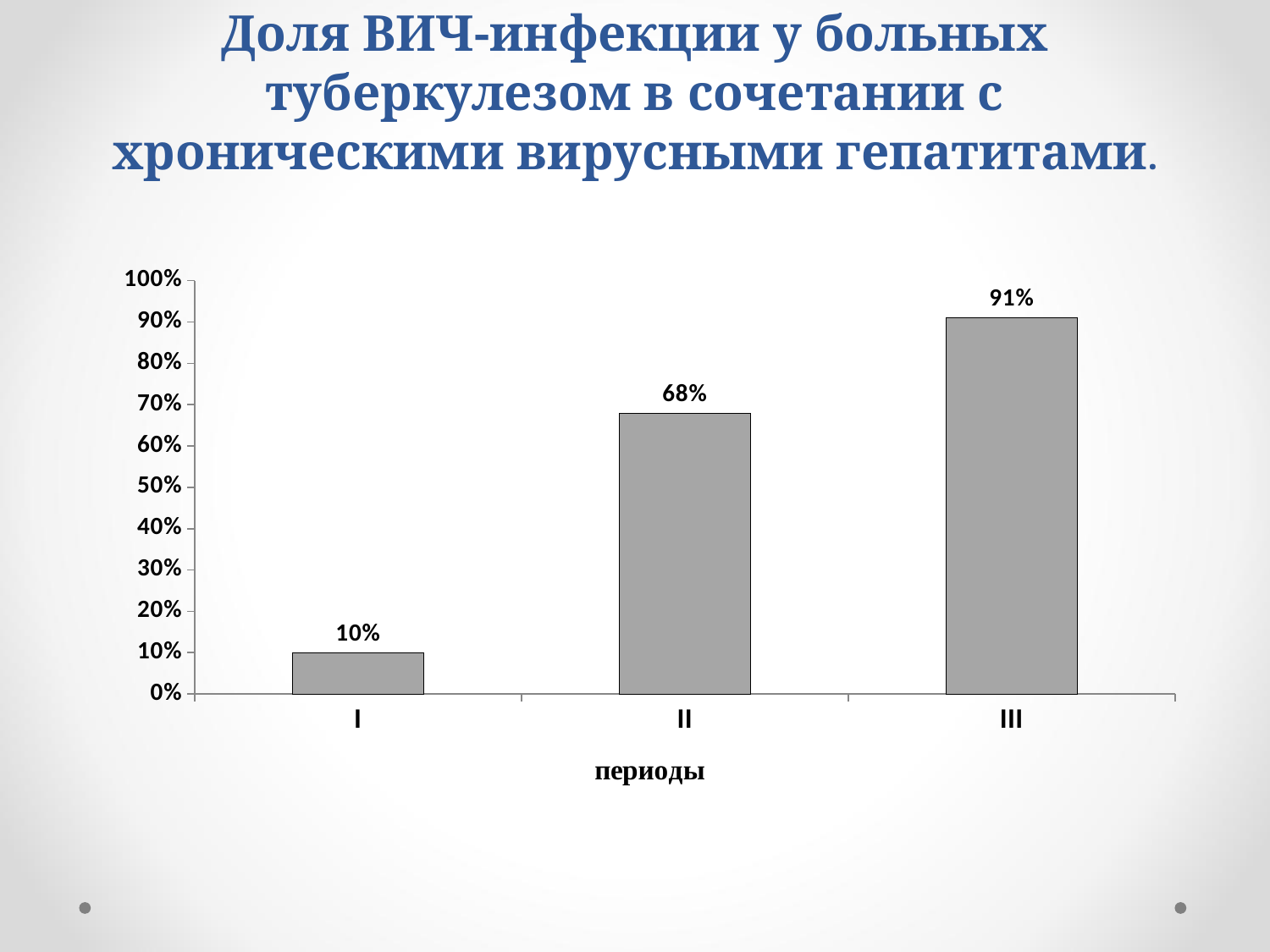
What is the value for period I? 10% Which period has the highest value? III What is the value for period II? 68% What is the difference between the values for period III and period II? 23% How many periods are shown on the x axis? 3 Do the values rise or fall from period I to period III? rise What is the value for period III? 91% Which period has the lowest value? I What is the difference between the values for period II and period I? 58% Which is larger, the value for period I or period II? II Is the value for period III greater or less than 80%? greater What kind of chart is shown on the slide? bar chart